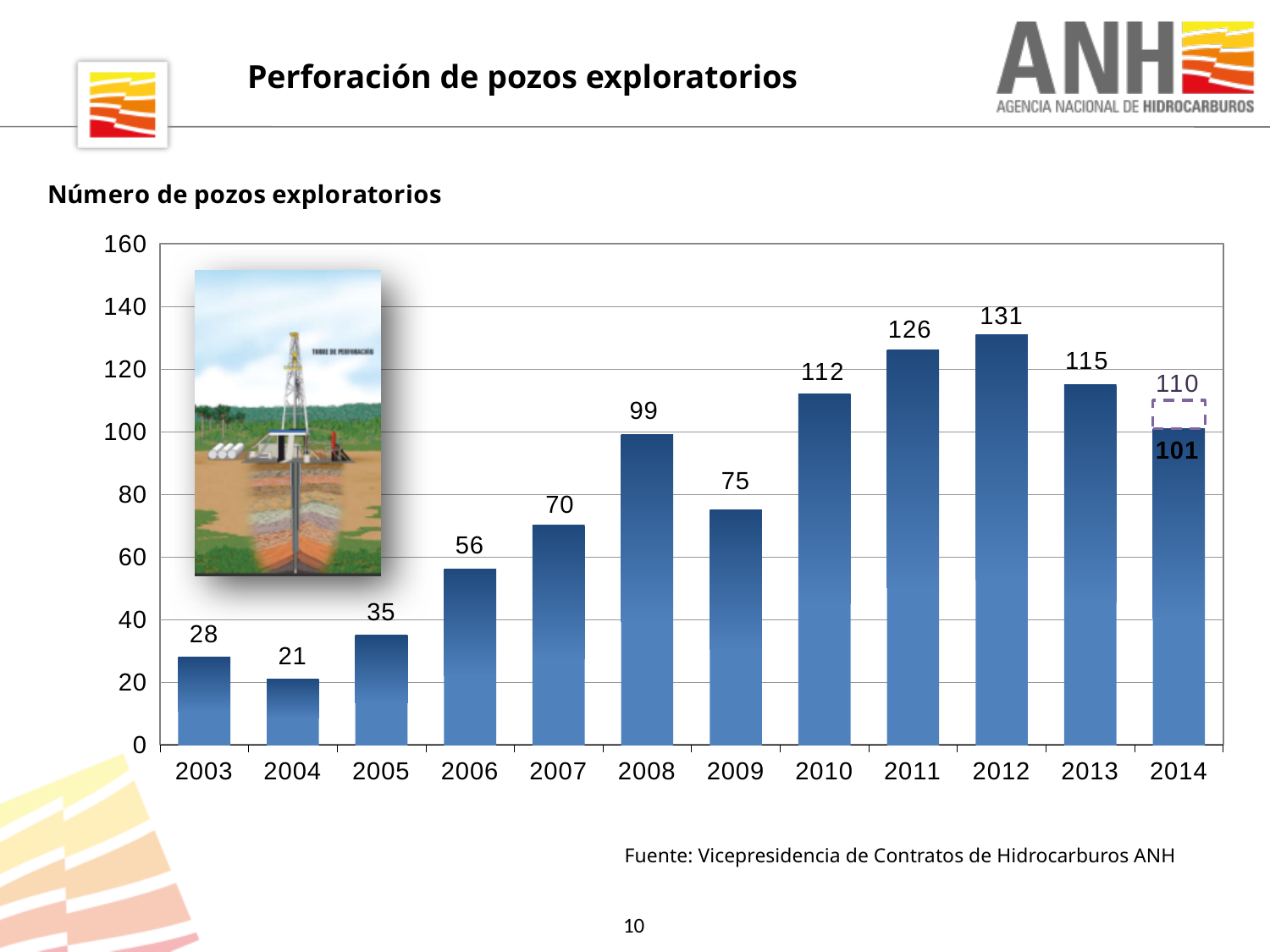
What is the difference between the values for 2008 and 2009? 24 Which year has the highest number of exploratory wells? 2012 What is the title shown above the chart? Número de pozos exploratorios Which is larger, the value for 2010 or the value for 2013? 2013 What is the difference between the values for 2012 and 2013? 16 Which year has the lowest number of exploratory wells? 2004 What is the value of the solid bar for 2014? 101 What is the number of exploratory wells for 2008? 99 How many years are shown on the x axis? 12 Is the value for 2011 greater or less than 120? greater What is the number of exploratory wells for 2004? 21 What kind of chart is shown on the slide? bar chart